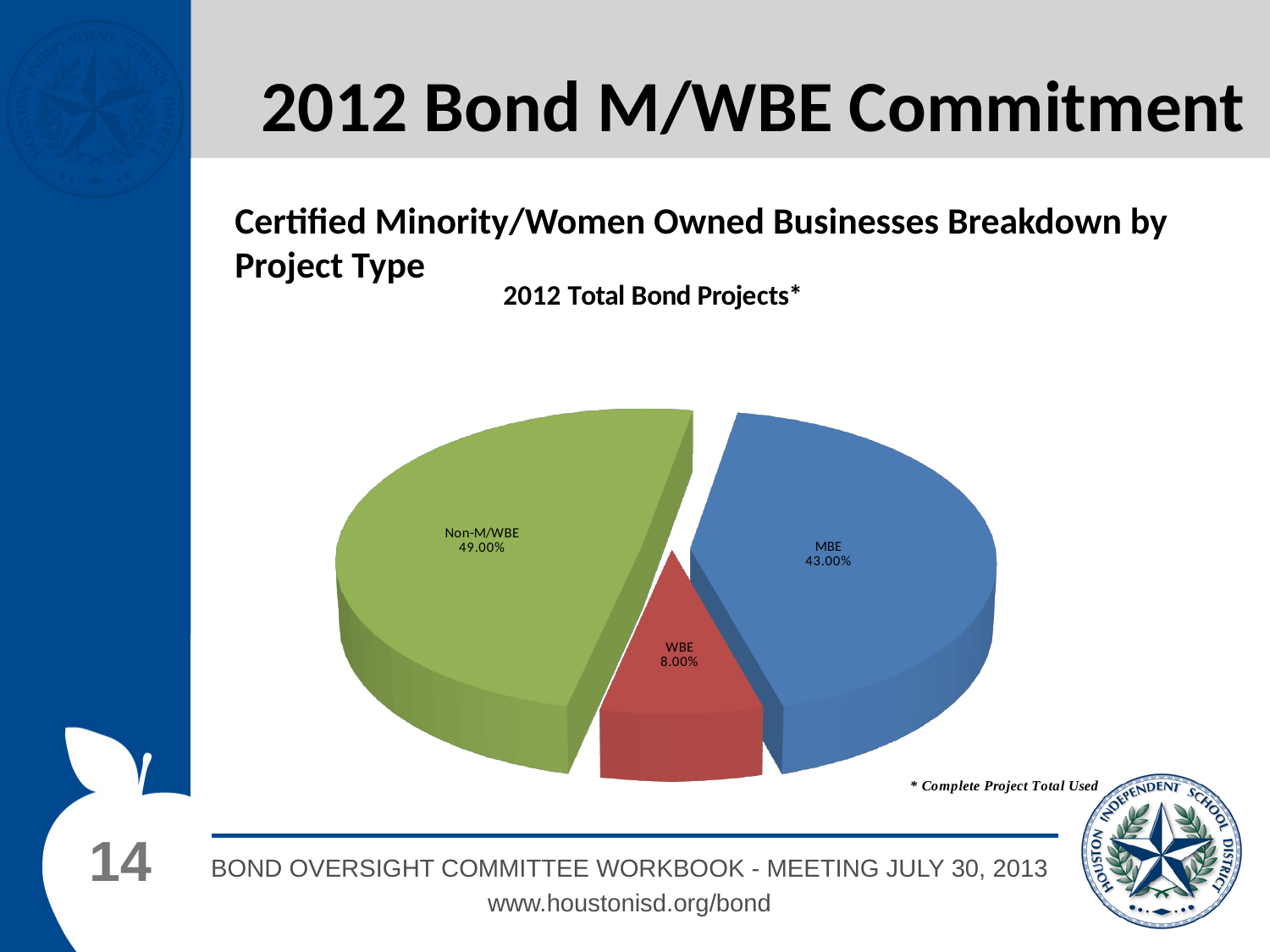
What percentage of the pie is Non-M/WBE? 49.00% What is the title of the chart? 2012 Total Bond Projects* Which category has the smallest share of the pie? WBE How many slices does the pie chart have? 3 Which category has the largest share of the pie? Non-M/WBE What percentage of the pie is WBE? 8.00% What is the difference in percentage points between Non-M/WBE and MBE? 6.00% What colour is the WBE slice? Red What is the difference in percentage points between MBE and WBE? 35.00% What type of chart is shown on the slide? Pie chart Which is larger, the MBE share or the WBE share? MBE What percentage of the pie is MBE? 43.00%